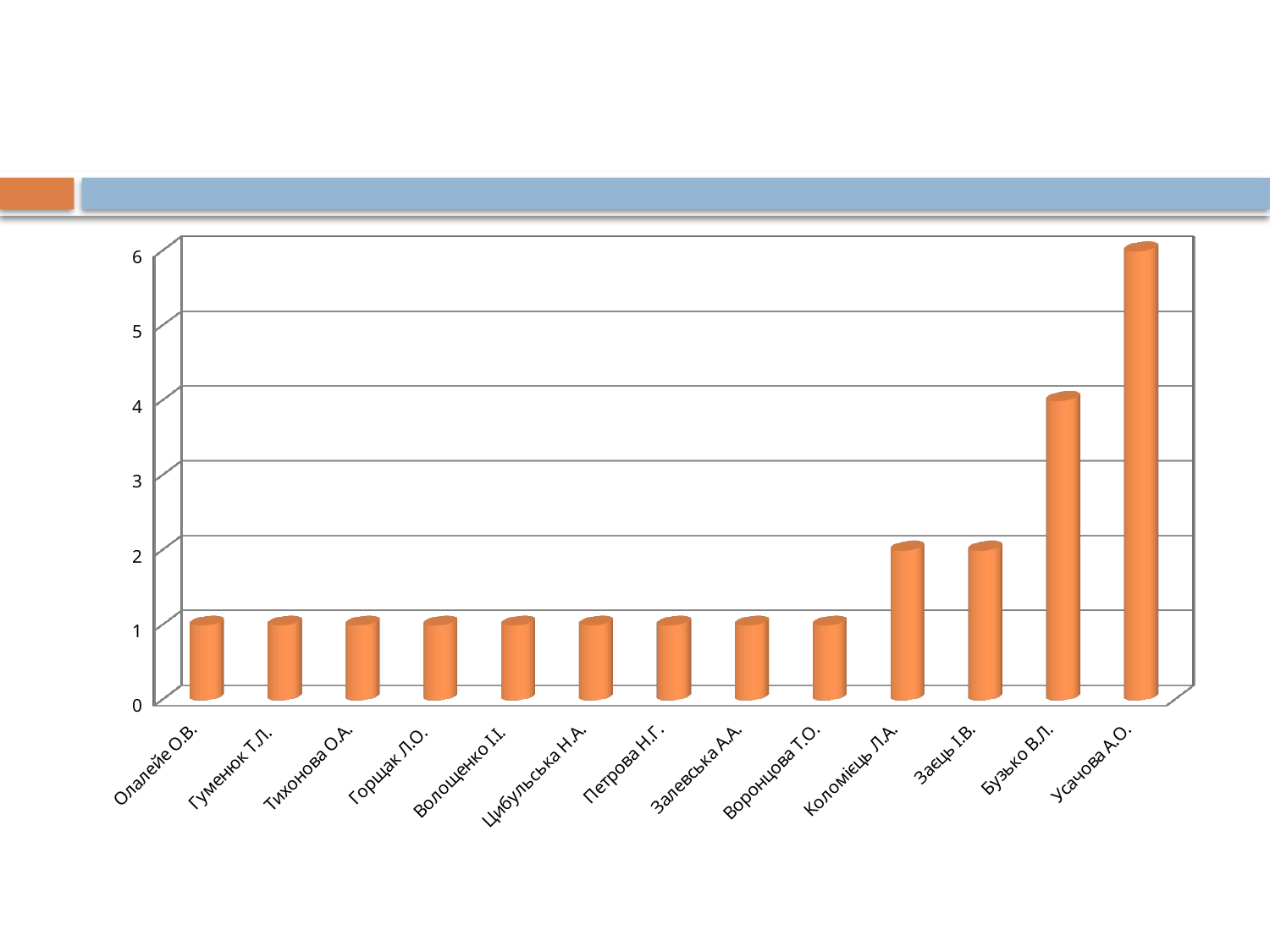
Which is larger, the value for Заєць І.В. or the value for Воронцова Т.О.? Заєць І.В. Which category has the highest value in the chart? Усачова А.О. Is the value for Бузько В.Л. greater or less than 3? greater What is the highest value shown on the vertical axis of the chart? 6 What is the value for Олалейе О.В.? 1 What is the value for Коломієць Л.А.? 2 What is the value for Усачова А.О.? 6 What is the value for Бузько В.Л.? 4 What is the difference between the values for Усачова А.О. and Бузько В.Л.? 2 What kind of chart is shown on the slide? bar chart How many categories (names) are shown on the x axis of the chart? 13 How many categories have a value of 1? 9